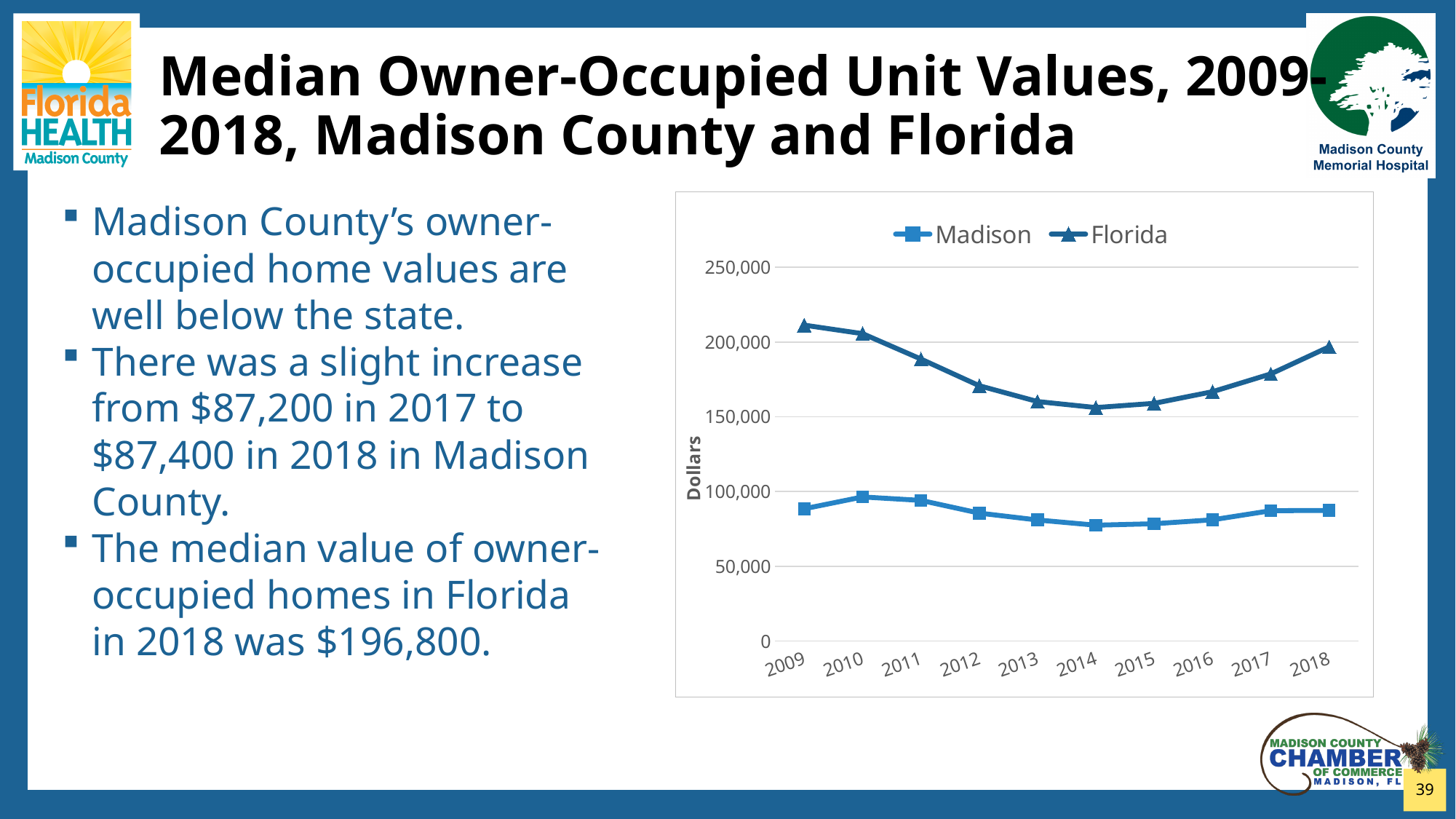
How many years are plotted along the x axis of the chart? 10 In which year is the Florida series at its lowest value? 2014 What is the title of the chart's vertical axis? Dollars In which year is the Florida series at its highest value? 2009 How many series does the chart's legend list? 2 What kind of chart is shown on the slide? line chart Is the value for Florida in 2009 greater or less than 200,000? greater Is the value for Madison in 2009 greater or less than 50,000? greater Is the value for Madison in 2014 greater or less than 100,000? less Does the Florida series rise or fall from 2009 to 2014? fall Which series has the larger value in 2018, Madison or Florida? Florida